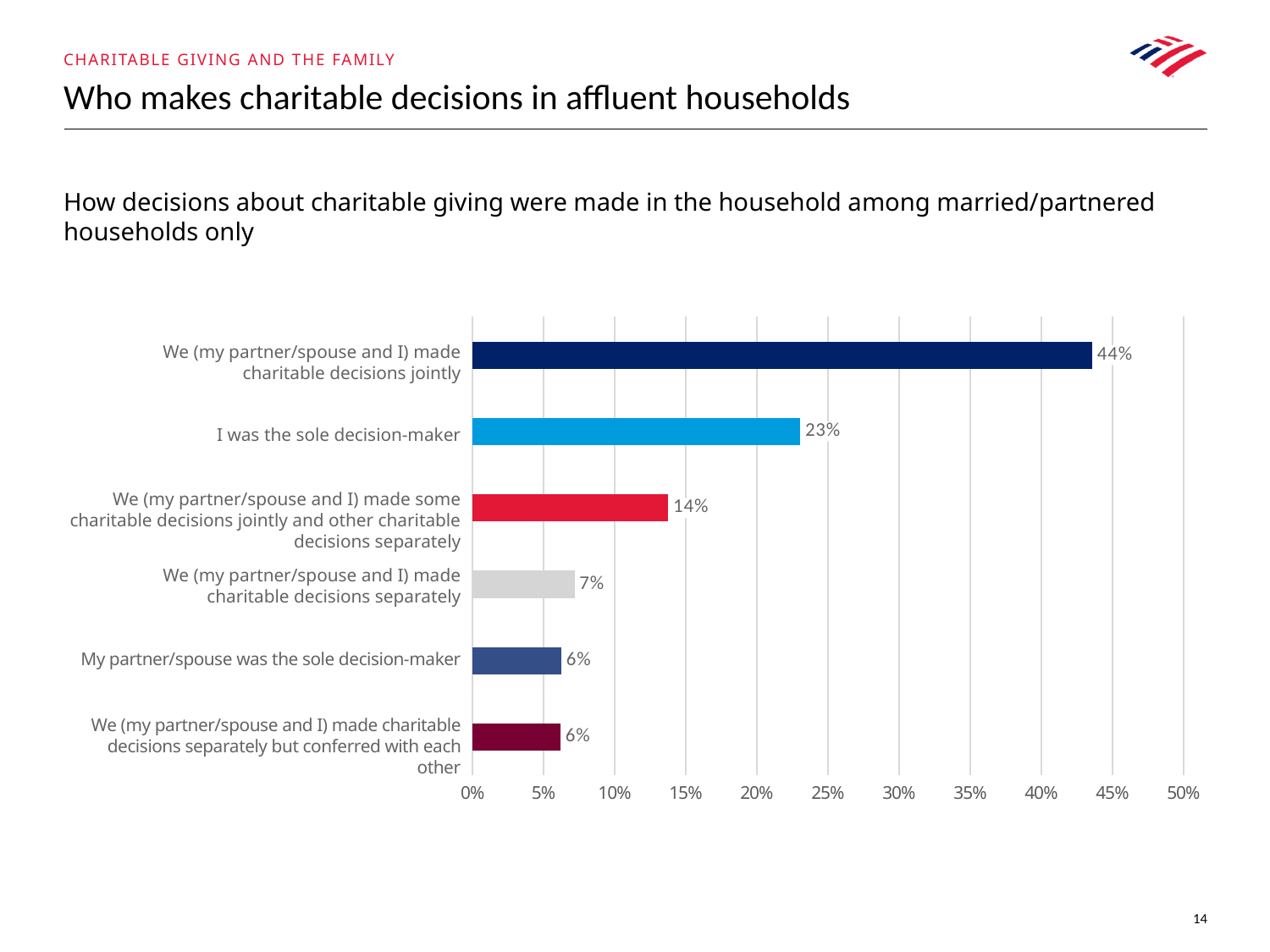
What is the maximum value shown on the horizontal axis of the chart? 50% Which is larger: the share who made charitable decisions separately, or the share who said 'My partner/spouse was the sole decision-maker'? We (my partner/spouse and I) made charitable decisions separately What kind of chart is shown on the slide? Bar chart What percentage of married/partnered households made charitable decisions jointly (partner/spouse and I)? 44% What is the difference between the share who made charitable decisions jointly and the share who said 'I was the sole decision-maker'? 21 percentage points Which category has the highest value in the chart? We (my partner/spouse and I) made charitable decisions jointly What percentage said 'My partner/spouse was the sole decision-maker'? 6% How many categories are shown in the chart? 6 What is the difference between the share who made some decisions jointly and others separately and the share who made charitable decisions separately? 7 percentage points What percentage made some charitable decisions jointly and other charitable decisions separately? 14% Is the value for 'I was the sole decision-maker' greater or less than 20%? greater What percentage of respondents said 'I was the sole decision-maker'? 23%